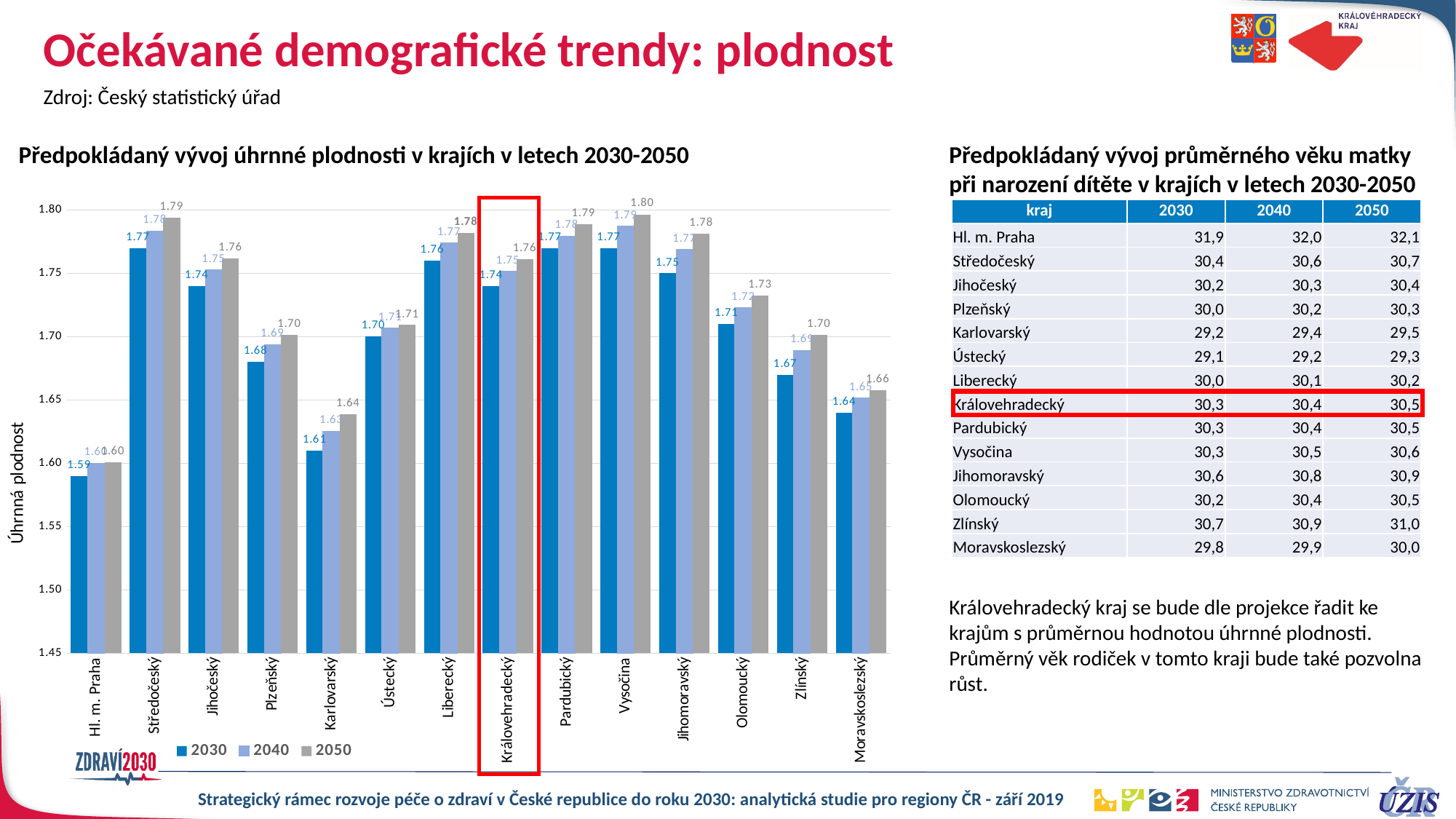
Which region has the lowest value in the 2030 series? Hl. m. Praha How many regions (kraje) are shown on the x axis of the chart? 14 Which is larger: the 2050 value for Moravskoslezský or the 2050 value for Karlovarský? Moravskoslezský What is the difference between the 2050 values for Vysočina and Hl. m. Praha? 0.20 What is the value for Hl. m. Praha in 2030? 1.59 What is the projected total fertility rate for Královehradecký in 2050? 1.76 Which region has the highest value in the 2050 series? Vysočina How many series does the chart legend list? 3 Do the values for Královehradecký rise or fall from 2030 to 2050? rise What type of chart is shown on the slide? bar chart Is the 2030 value for Karlovarský greater or less than 1.65? less What is the label of the y axis of the chart? Úhrnná plodnost